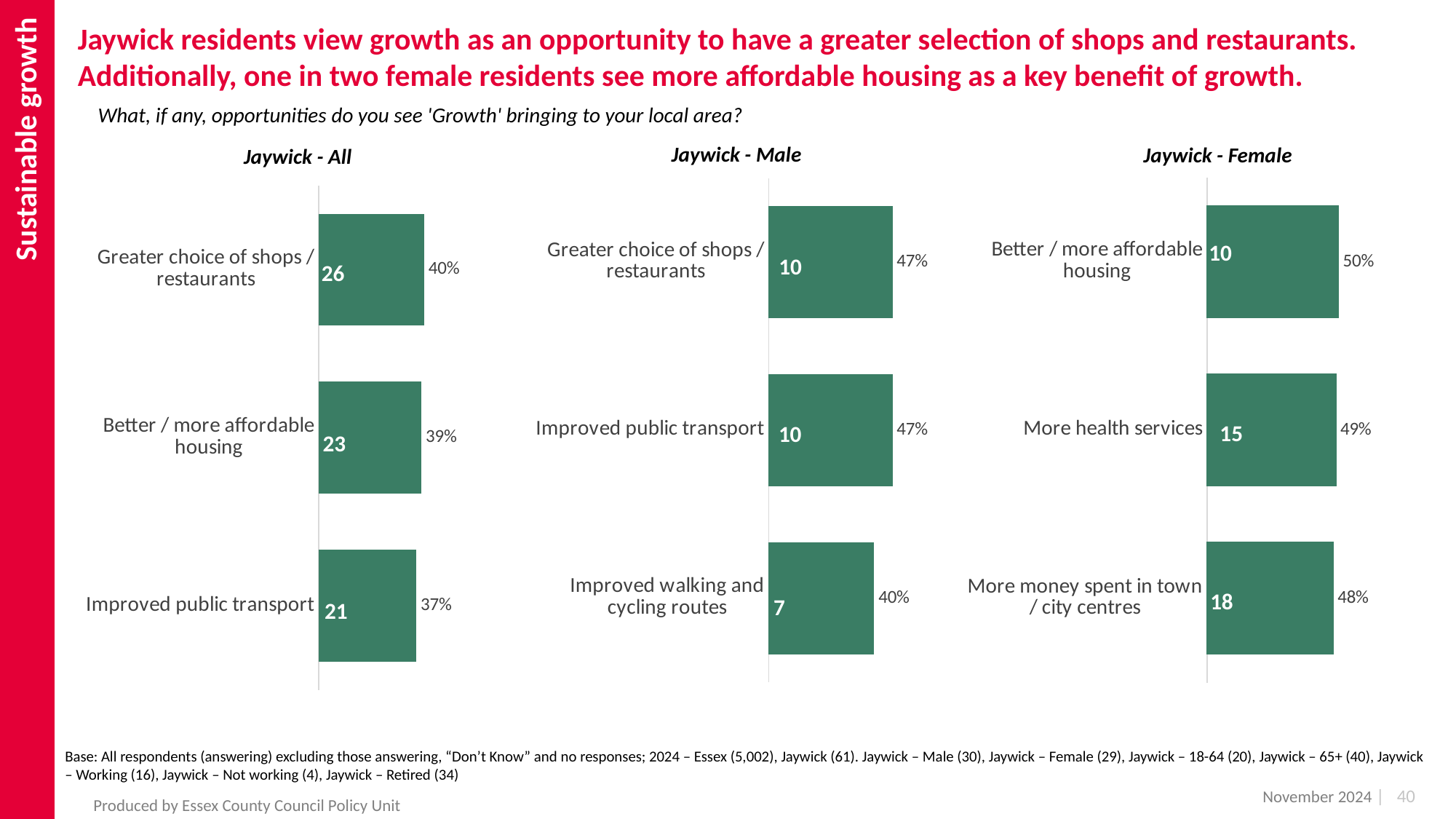
In the 'Jaywick - All' chart, which category has the highest percentage? Greater choice of shops / restaurants In the 'Jaywick - Female' chart, what percentage is shown for 'More health services'? 49% In the 'Jaywick - Female' chart, which category has the lowest percentage? More money spent in town / city centres How many categories are shown in the 'Jaywick - Male' chart? 3 What type of chart is the 'Jaywick - Female' chart? Bar chart In the 'Jaywick - All' chart, what is the difference in percentage points between 'Greater choice of shops / restaurants' and 'Improved public transport'? 3 In the 'Jaywick - Male' chart, what is the difference between the counts for 'Greater choice of shops / restaurants' and 'Improved walking and cycling routes'? 3 In the 'Jaywick - All' chart, what count is printed inside the bar for 'Improved public transport'? 21 Which is larger: the percentage for 'Better / more affordable housing' in the 'Jaywick - Female' chart or in the 'Jaywick - All' chart? Jaywick - Female In the 'Jaywick - Male' chart, what percentage is shown for 'Improved walking and cycling routes'? 40% In the 'Jaywick - Female' chart, what count is printed inside the bar for 'More money spent in town / city centres'? 18 In the 'Jaywick - All' chart, what percentage is shown for 'Greater choice of shops / restaurants'? 40%